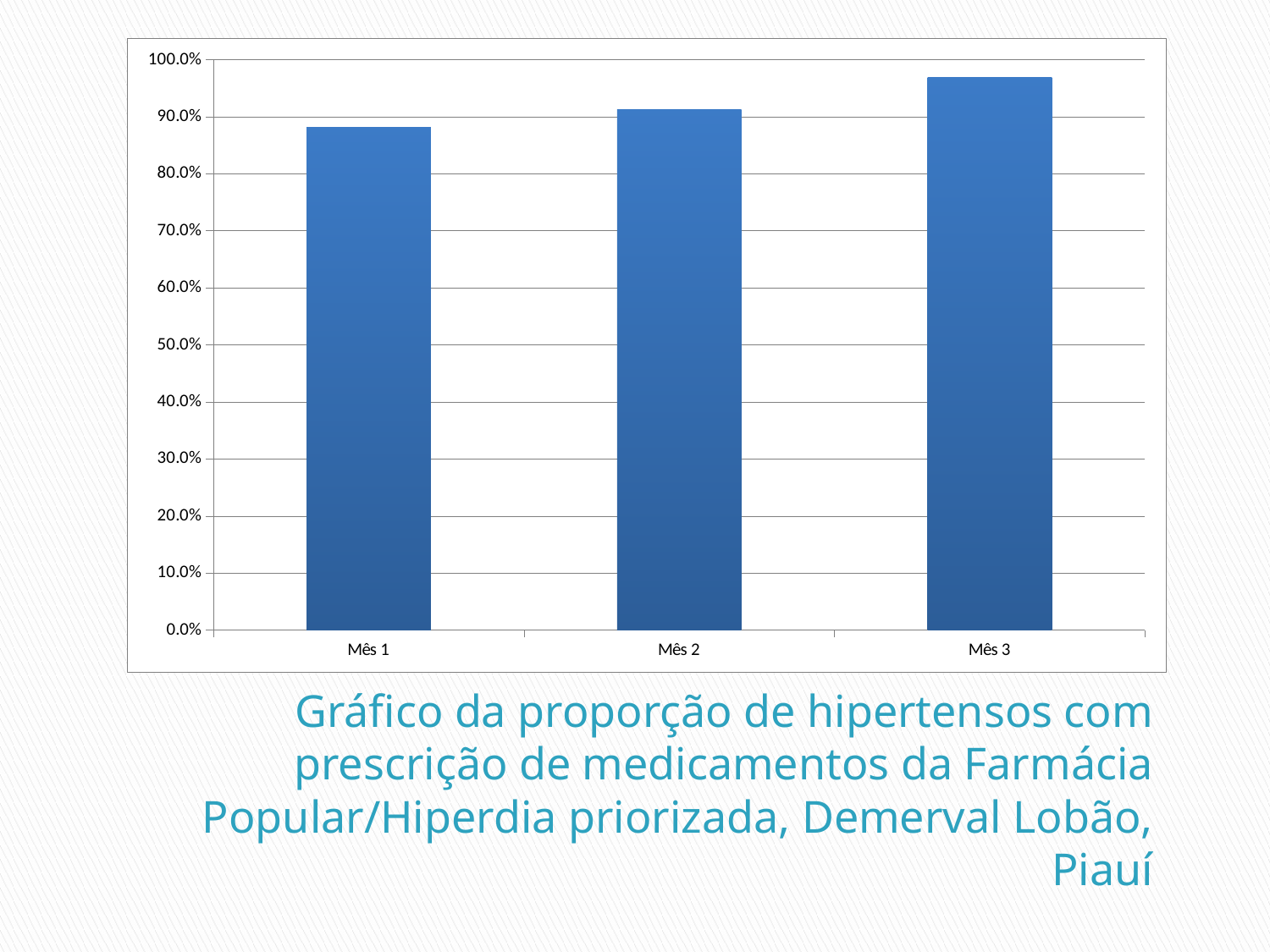
Is the value for Mês 2 greater or less than 90.0%? greater What is the highest value shown on the vertical axis? 100.0% What kind of chart is shown on the slide? bar chart Do the values rise or fall from Mês 1 to Mês 3? rise Which month has the lowest bar? Mês 1 How many categories are plotted on the x axis? 3 Is the value for Mês 1 greater or less than 90.0%? less Which is larger, the value for Mês 1 or the value for Mês 3? Mês 3 Which is larger, the value for Mês 1 or the value for Mês 2? Mês 2 Is the value for Mês 3 greater or less than 90.0%? greater Which month has the highest bar? Mês 3